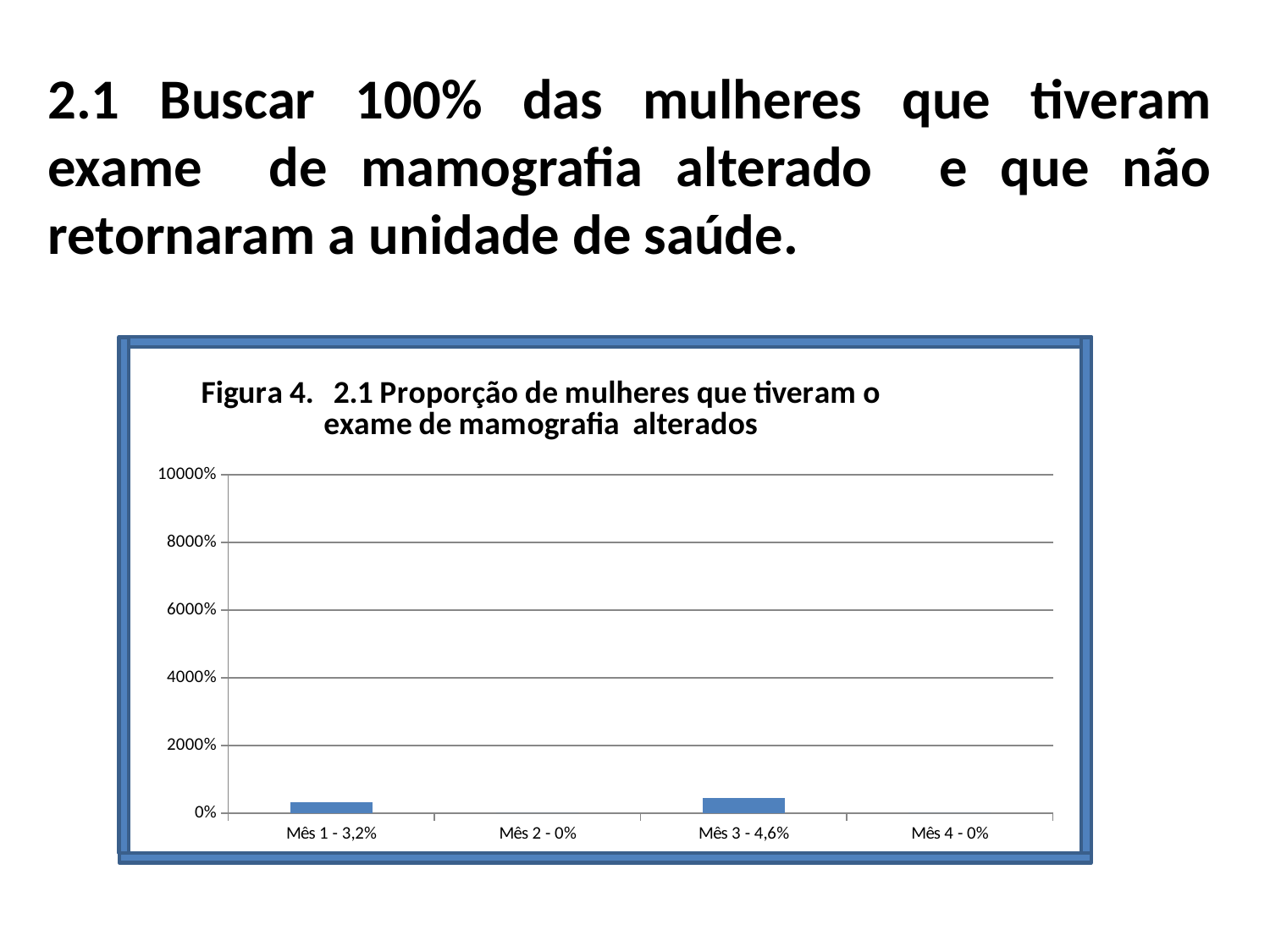
What is the figure number given in the chart title? Figura 4 What percentage is shown in the x-axis label for Mês 4? 0% Is the bar for Mês 3 greater or less than 2000% on the y axis? less Which month has the highest bar in the chart? Mês 3 What percentage is shown in the x-axis label for Mês 2? 0% What is the difference between the percentages labelled for Mês 3 and Mês 1? 1,4% What is the highest value shown on the y axis of the chart? 10000% What percentage is shown in the x-axis label for Mês 1? 3,2% What kind of chart is shown on the slide? bar chart What percentage is shown in the x-axis label for Mês 3? 4,6% Which is larger, the value for Mês 1 or the value for Mês 3? Mês 3 How many categories (months) are shown on the x axis of the chart? 4